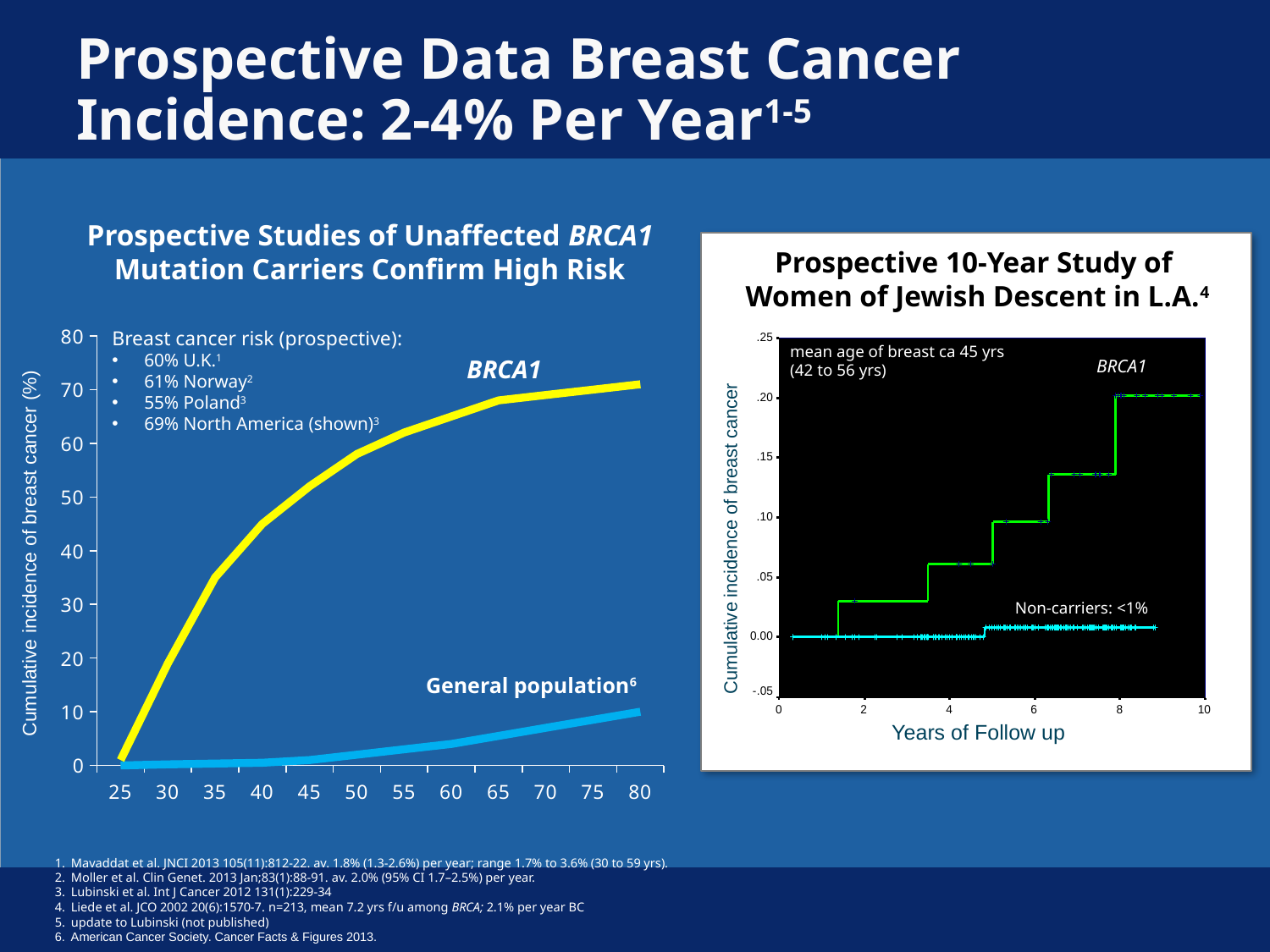
In the left chart, which line is higher at age 80, BRCA1 or General population? BRCA1 In the right chart, what cumulative incidence is annotated for Non-carriers? <1% In the left chart, is the BRCA1 cumulative incidence at age 80 greater or less than 60? greater What is the x-axis label of the right chart? Years of Follow up What kind of chart is the left chart, 'Prospective Studies of Unaffected BRCA1 Mutation Carriers Confirm High Risk'? line chart In the left chart, is the BRCA1 cumulative incidence at age 50 greater or less than 50? greater How many lines are plotted in the left chart? 2 How many age tick labels are shown on the x axis of the left chart? 12 In the left chart, does the BRCA1 line rise or fall as age increases from 25 to 80? rise In the right chart, which group has the higher cumulative incidence at 8 years, BRCA1 or Non-carriers? BRCA1 In the left chart, is the General population cumulative incidence at age 80 greater or less than 20? less